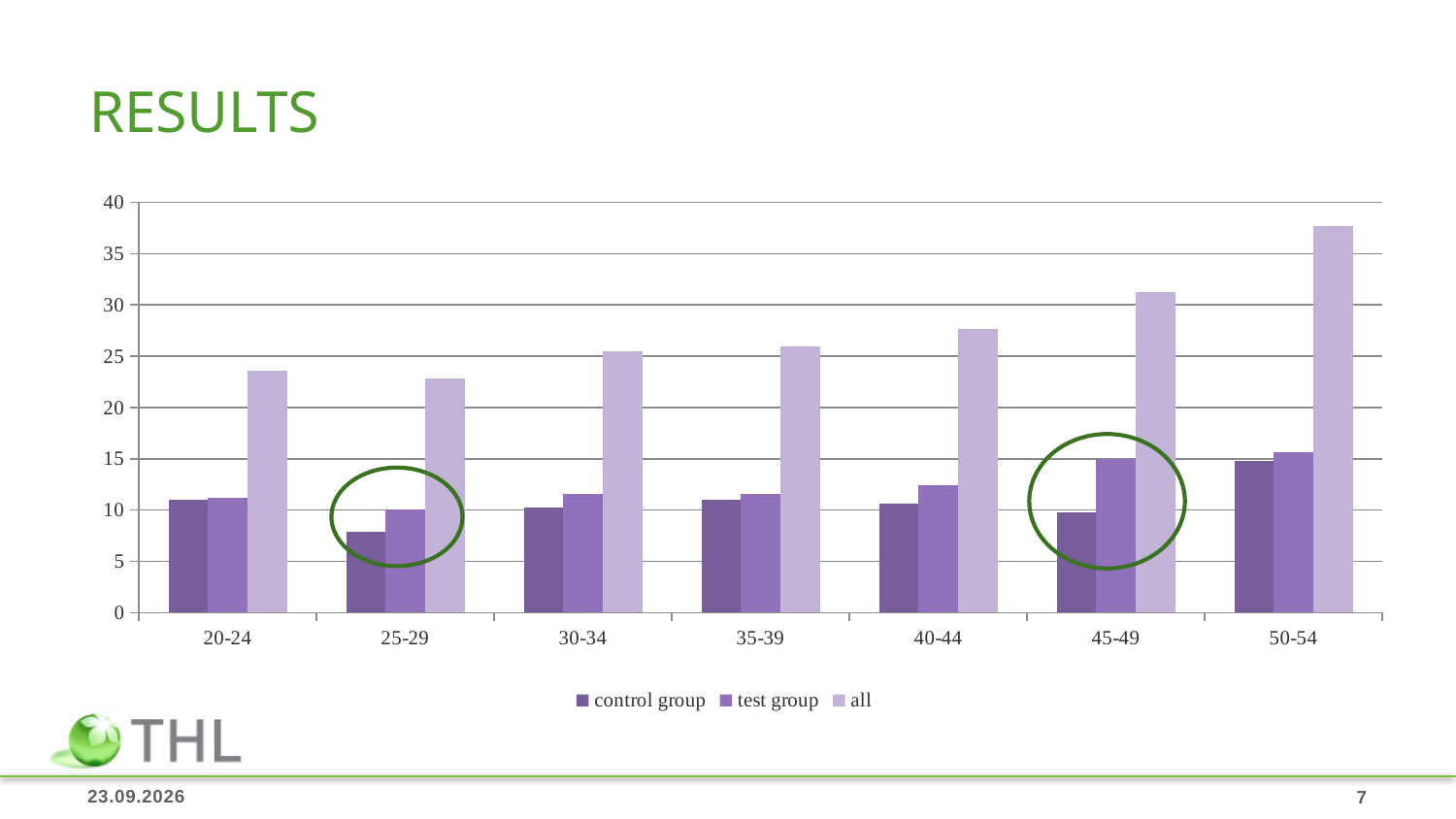
Which age group has the highest value for the 'all' series? 50-54 Which age group has the lowest value for the control group? 25-29 Which age group has the highest value for the control group? 50-54 From 30-34 to 50-54, does the 'all' series rise or fall along the x axis? rise How many series does the legend list? 3 Is the value for 'all' in the 45-49 age group greater or less than 30? greater In the 45-49 age group, which is larger: the control group or the test group? test group Which age group has the lowest value for the 'all' series? 25-29 Is the value for the control group in the 25-29 age group greater or less than 10? less What kind of chart is shown on the slide? bar chart Is the value for 'all' in the 50-54 age group greater or less than 35? greater How many age-group categories are shown on the x axis? 7